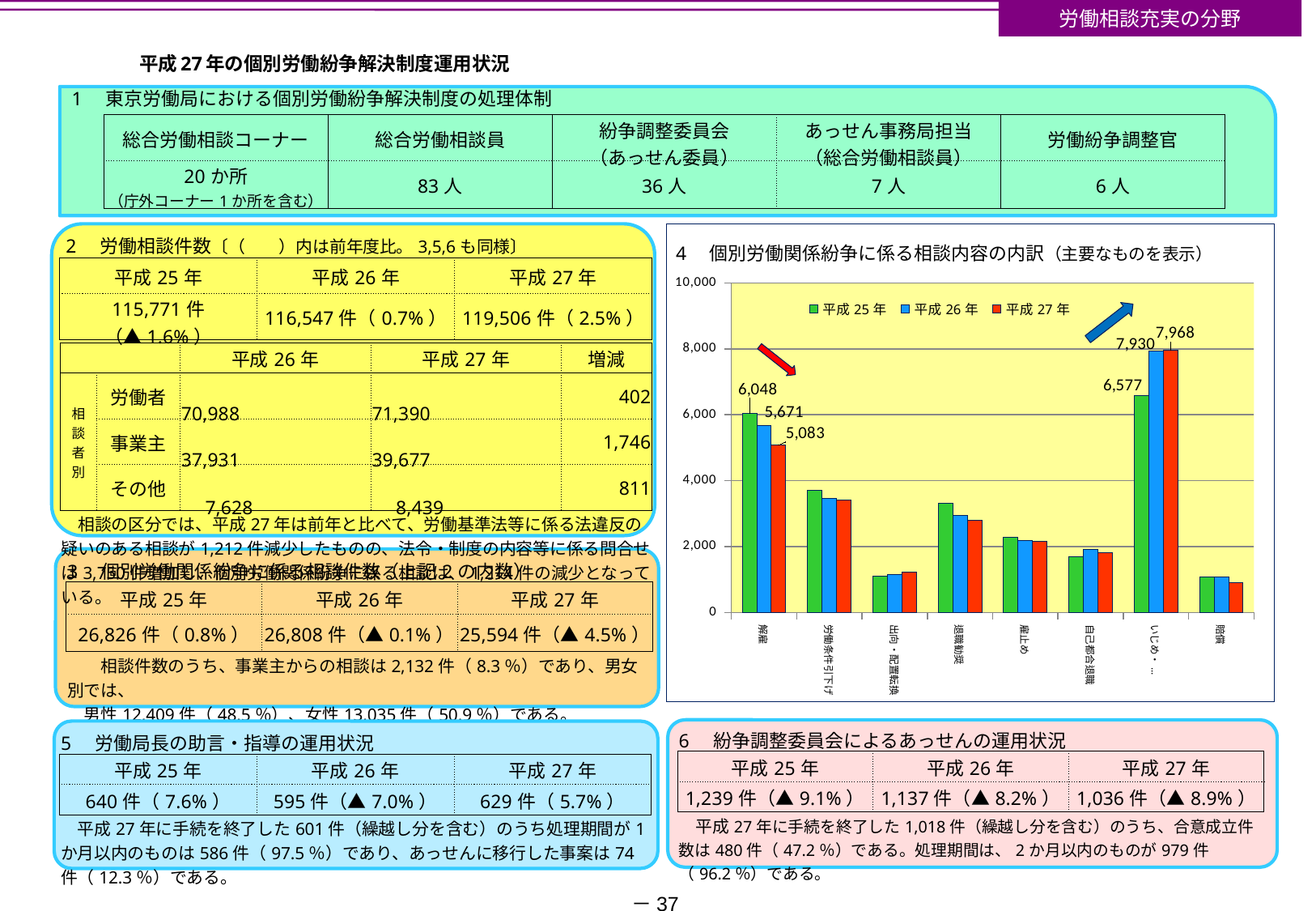
In the chart 個別労働関係紛争に係る相談内容の内訳, is the value for 労働条件引下げ in 平成25年 greater or less than 4,000? less In the chart 個別労働関係紛争に係る相談内容の内訳, what is the value for いじめ・… in 平成27年? 7,968 How many series does the legend of the chart 個別労働関係紛争に係る相談内容の内訳 list? 3 In the chart 個別労働関係紛争に係る相談内容の内訳, which category has the highest value in 平成27年? いじめ・… In the chart 個別労働関係紛争に係る相談内容の内訳, which is larger in 平成26年: 解雇 or いじめ・…? いじめ・… In the chart 個別労働関係紛争に係る相談内容の内訳, by how much did the value for 解雇 fall from 平成25年 to 平成27年? 965 In the chart 個別労働関係紛争に係る相談内容の内訳, what is the value for 解雇 in 平成25年? 6,048 In the chart 個別労働関係紛争に係る相談内容の内訳, do the values for 解雇 rise or fall from 平成25年 to 平成27年? fall In the chart 個別労働関係紛争に係る相談内容の内訳, what is the difference between the いじめ・… values for 平成27年 and 平成25年? 1,391 In the chart 個別労働関係紛争に係る相談内容の内訳, what is the value for いじめ・… in 平成26年? 7,930 In the chart 個別労働関係紛争に係る相談内容の内訳, what is the value for 解雇 in 平成27年? 5,083 How many categories are shown on the x axis of the chart 個別労働関係紛争に係る相談内容の内訳? 8